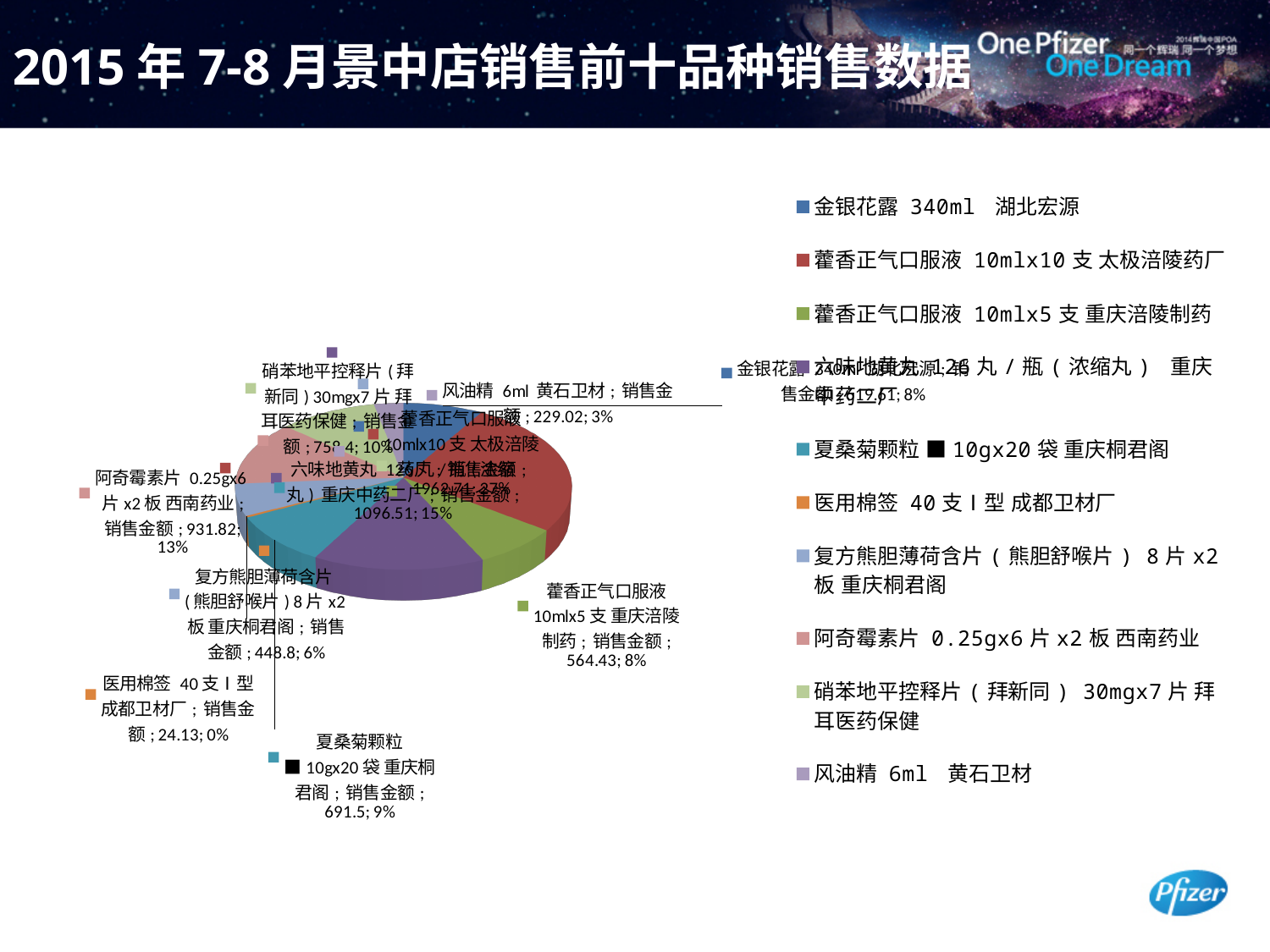
What is the sales amount for 夏桑菊颗粒 10gx20袋 重庆桐君阁? 691.5 What is the sales amount for 阿奇霉素片 0.25gx6片x2板 西南药业? 931.82 What share of the pie does 阿奇霉素片 0.25gx6片x2板 西南药业 account for? 13% What is the sales amount (销售金额) for 风油精 6ml 黄石卫材? 229.02 What is the difference in sales amount between 阿奇霉素片 0.25gx6片x2板 西南药业 and 夏桑菊颗粒 10gx20袋 重庆桐君阁? 240.32 How many products (slices) does the pie chart show? 10 Which has the larger sales amount: 夏桑菊颗粒 10gx20袋 重庆桐君阁 or 复方熊胆薄荷含片 8片x2板 重庆桐君阁? 夏桑菊颗粒 10gx20袋 重庆桐君阁 Which product has the smallest slice in the pie chart? 医用棉签 40支 I型 成都卫材厂 What is the sales amount for 医用棉签 40支 I型 成都卫材厂? 24.13 What kind of chart is shown on the slide? Pie chart What share of the pie does 藿香正气口服液 10mlx5支 重庆涪陵制药 account for? 8% What is the sales amount for 复方熊胆薄荷含片(熊胆舒喉片) 8片x2板 重庆桐君阁? 448.8